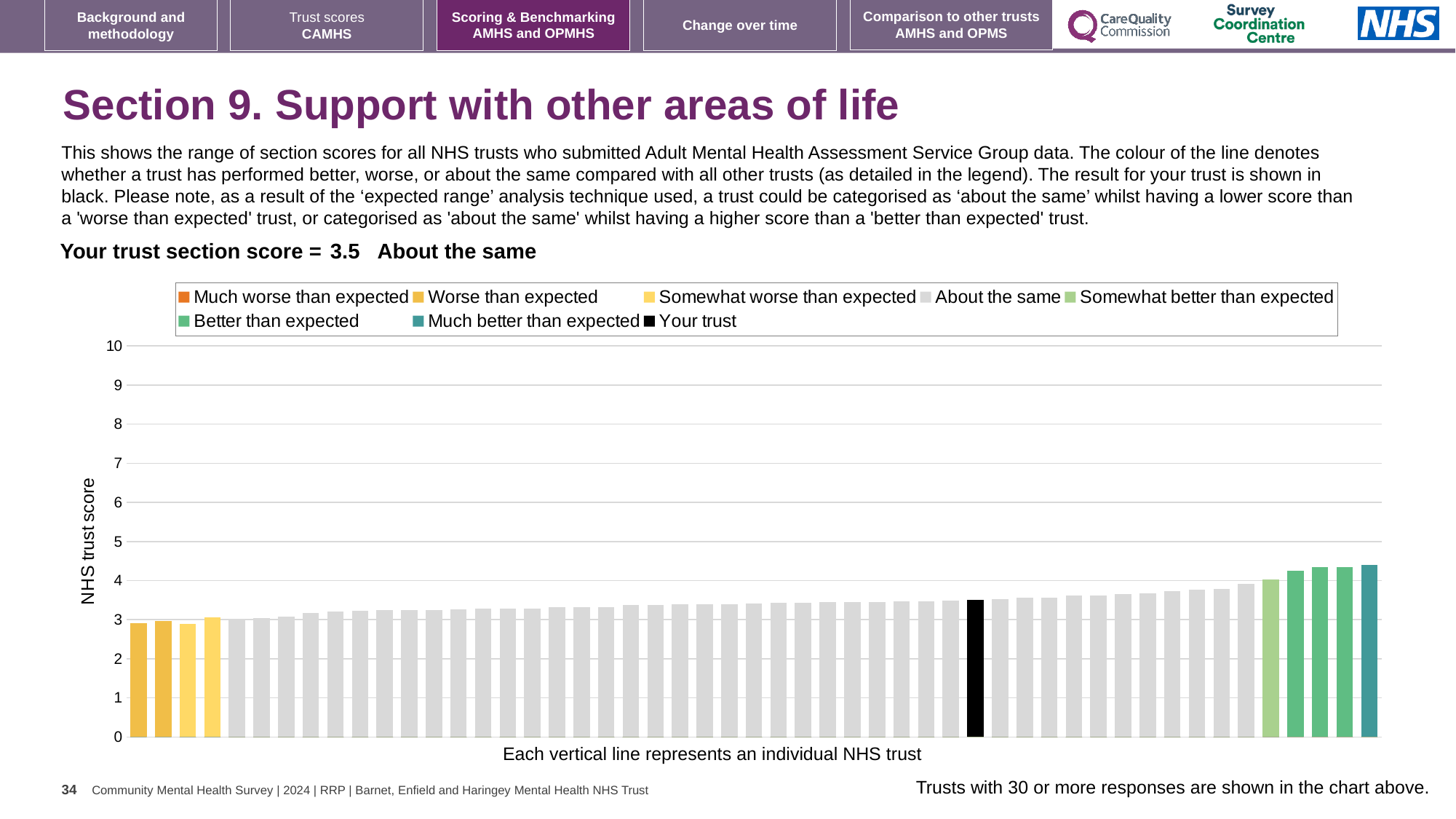
Is the value for your trust greater or less than 3? greater What is the label on the vertical axis of the chart? NHS trust score How many entries does the chart legend list? 8 What is the section score for your trust? 3.5 Is the value of the tallest bar (rightmost trust) greater or less than 4? greater What kind of chart is shown on the slide? bar chart How many bars are coloured as 'Much better than expected'? 1 Which is larger, the leftmost bar or the rightmost bar? the rightmost bar Is the value of the leftmost bar greater or less than 4? less What category is your trust's section score placed in? About the same Do the bar values rise or fall from left to right across the chart? rise